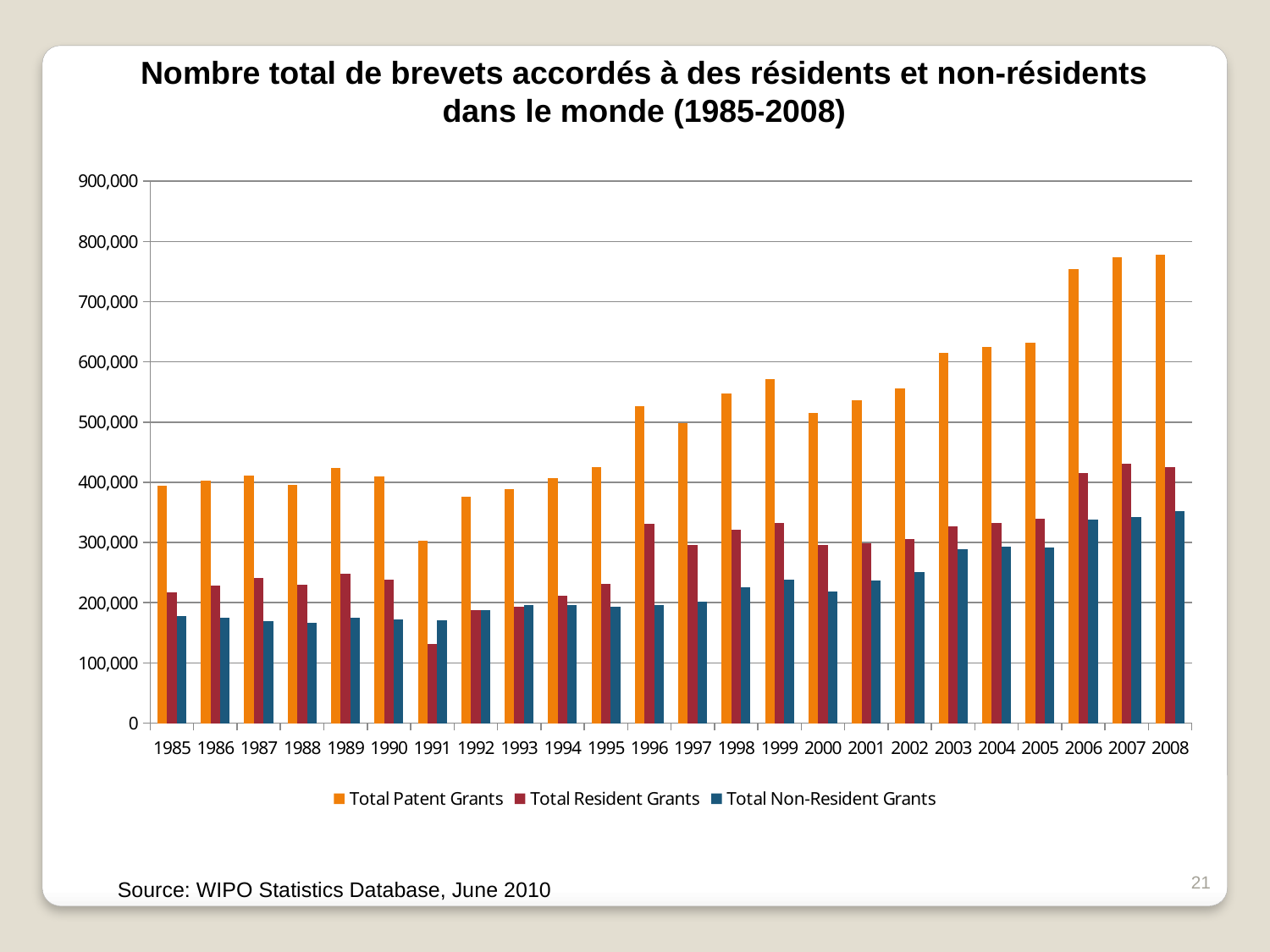
Do the values for Total Patent Grants generally rise or fall from 1985 to 2008? rise In which year is the value for Total Patent Grants the highest? 2008 Is the value for Total Patent Grants in 1991 greater or less than 400,000? less How many years are shown on the x axis? 24 In which year is the value for Total Resident Grants the lowest? 1991 Which is larger in 2008: Total Resident Grants or Total Non-Resident Grants? Total Resident Grants Is the value for Total Non-Resident Grants in 2008 greater or less than 300,000? greater What kind of chart is shown on the slide? bar chart How many series does the legend list? 3 Is the value for Total Non-Resident Grants in 1985 greater or less than 200,000? less In which year is the value for Total Patent Grants the lowest? 1991